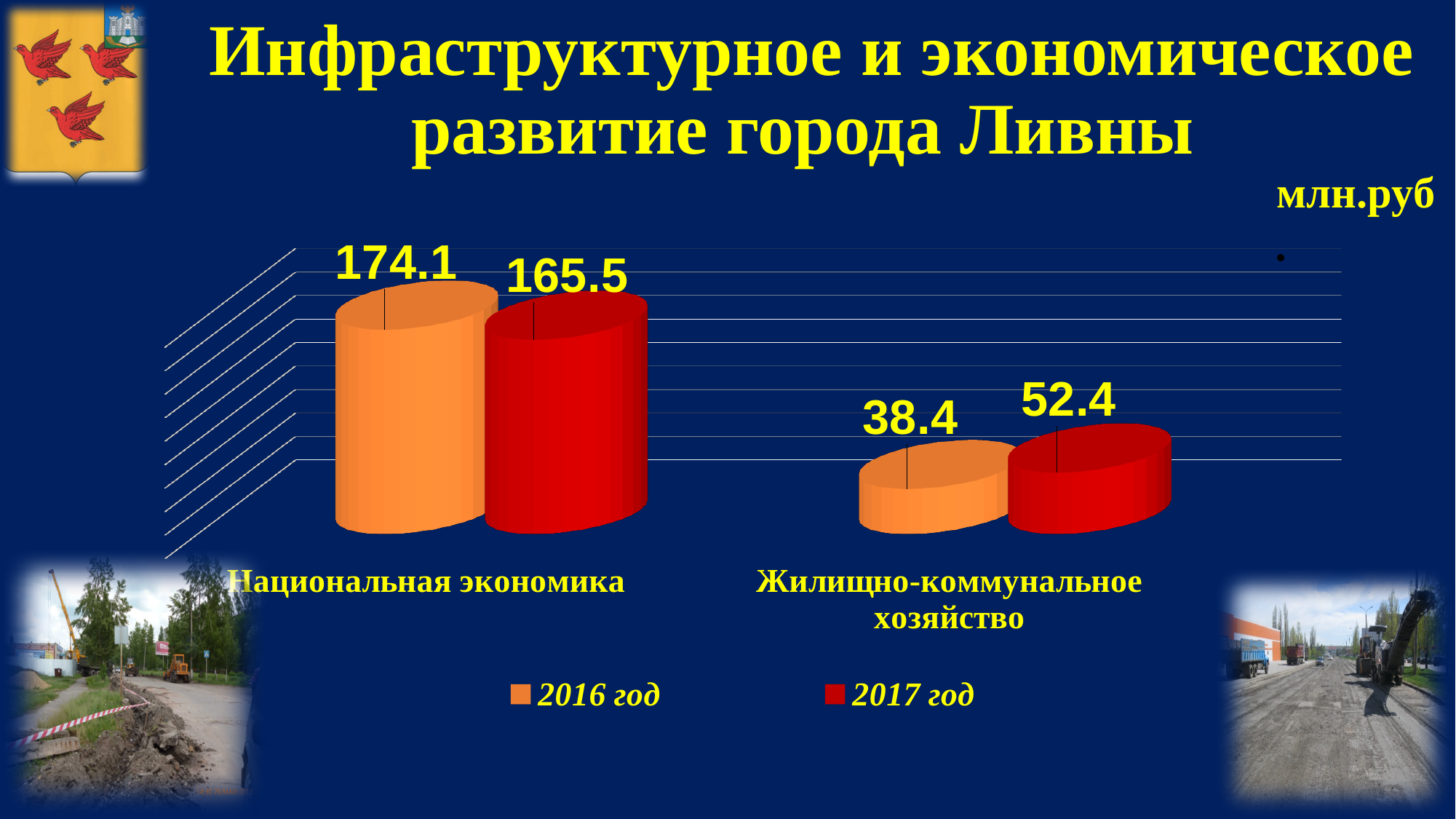
What kind of chart is shown on the slide? bar chart Which category has the highest value in 2017 год? Национальная экономика Which category has the lowest value in 2016 год? Жилищно-коммунальное хозяйство How many categories are shown on the x axis of the chart? 2 What is the value for Жилищно-коммунальное хозяйство in 2017 год? 52.4 What is the value for Жилищно-коммунальное хозяйство in 2016 год? 38.4 What is the difference between the 2016 год and 2017 год values for Национальная экономика? 8.6 What is the difference between the 2017 год and 2016 год values for Жилищно-коммунальное хозяйство? 14.0 What is the value for Национальная экономика in 2016 год? 174.1 For Жилищно-коммунальное хозяйство, which year has the larger value, 2016 год or 2017 год? 2017 год How many series does the chart legend list? 2 What is the value for Национальная экономика in 2017 год? 165.5